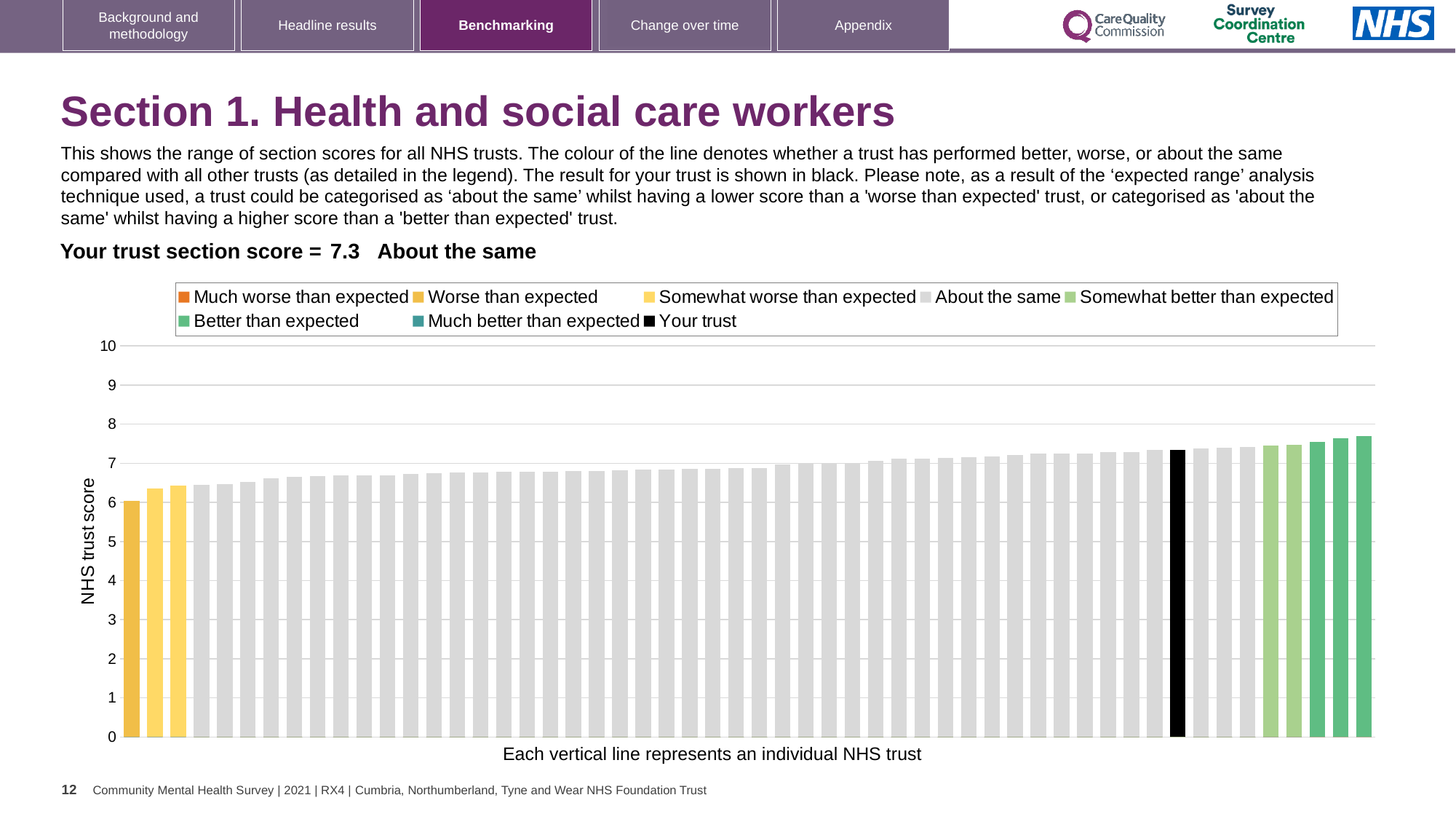
Is the value of the tallest bar greater or less than 8? less Which is taller, the black bar for your trust or the leftmost bar? The black bar for your trust How many bars are coloured yellow (worse than expected)? 3 Is the value of the black bar (your trust) greater or less than 7? greater What is the label on the vertical axis of the chart? NHS trust score What is the section score for your trust shown on the slide? 7.3 Do the bar values rise or fall from left to right across the chart? Rise How many entries does the chart legend list? 8 Is the value of the shortest bar greater or less than 5? greater Which benchmarking category is your trust placed in for this section? About the same What kind of chart is shown on the slide? Bar chart